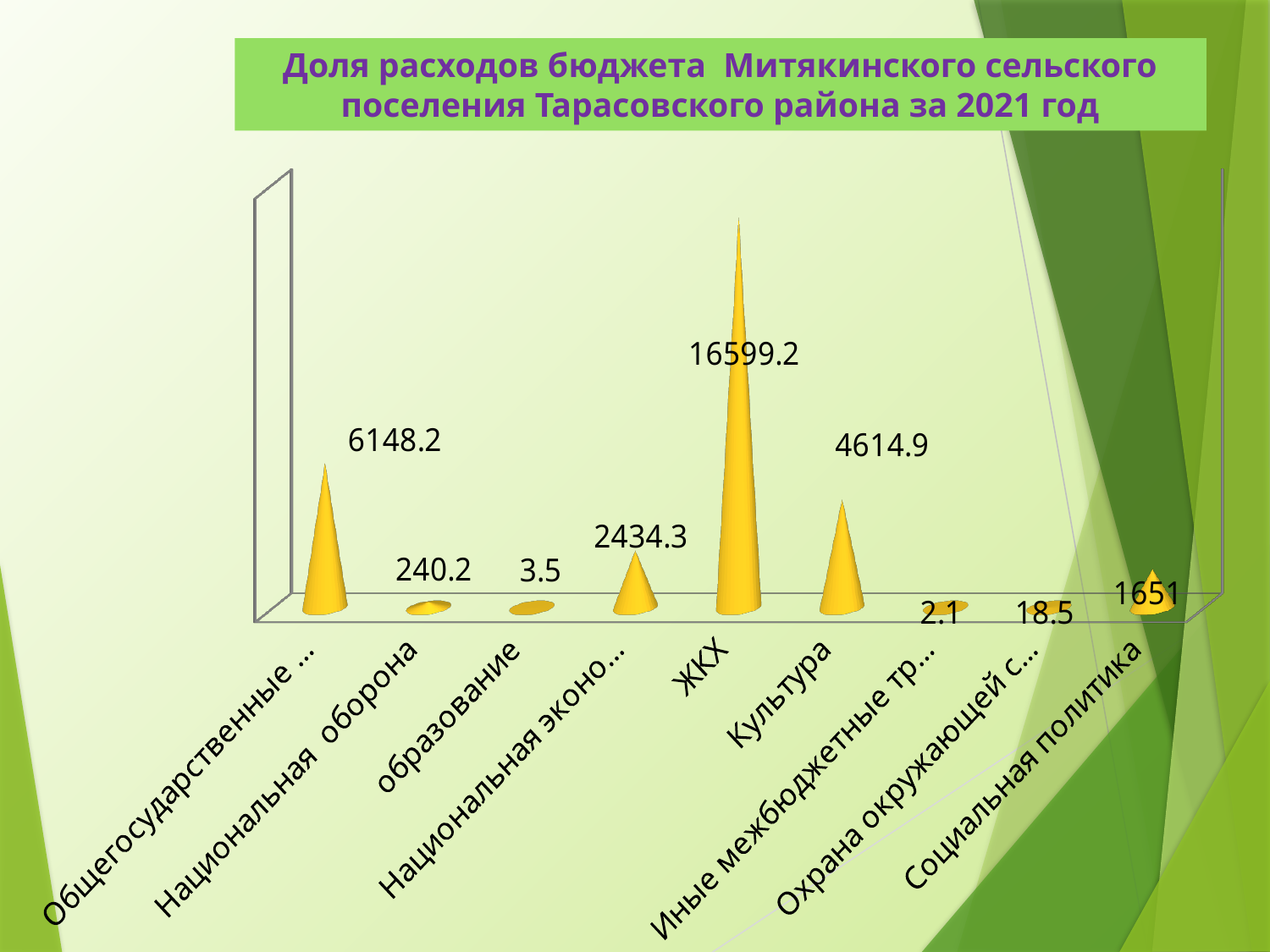
What is the value for ЖКХ? 16599.2 What is the value for образование? 3.5 What is the value for Культура? 4614.9 Which category has the lowest value? Иные межбюджетные тр... How many categories are shown on the chart? 9 What kind of chart is shown on the slide? 3D bar chart (cone-shaped bars) Which category has the highest value? ЖКХ Which is larger, the value for Культура or the value for Социальная политика? Культура What is the difference between the values for ЖКХ and Культура? 11984.3 What is the value for Национальная оборона? 240.2 What is the title of the chart? Доля расходов бюджета Митякинского сельского поселения Тарасовского района за 2021 год What is the value for Социальная политика? 1651